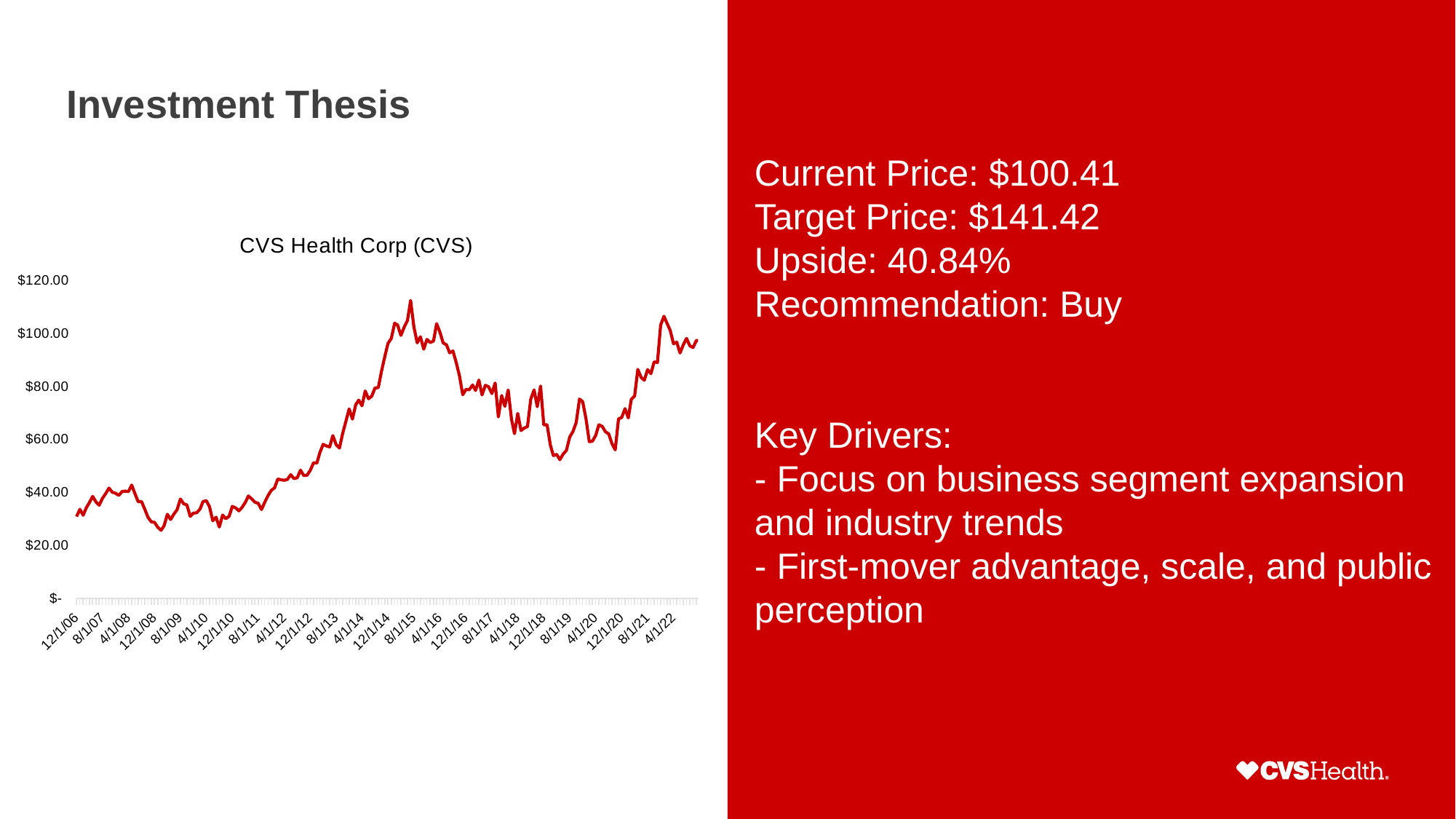
What colour is the line in the chart? red Does the line overall rise or fall between 12/1/06 and 8/1/15? rise Is the value at 4/1/22 greater or less than $80.00? greater Is the value at 12/1/08 greater or less than $40.00? less Is the value at 12/1/14 greater or less than $80.00? greater Around which x-axis label does the line reach its highest point? 8/1/15 What kind of chart is shown on the slide? line chart Which is larger, the value at 8/1/15 or the value at 8/1/19? 8/1/15 What is the title of the chart? CVS Health Corp (CVS)